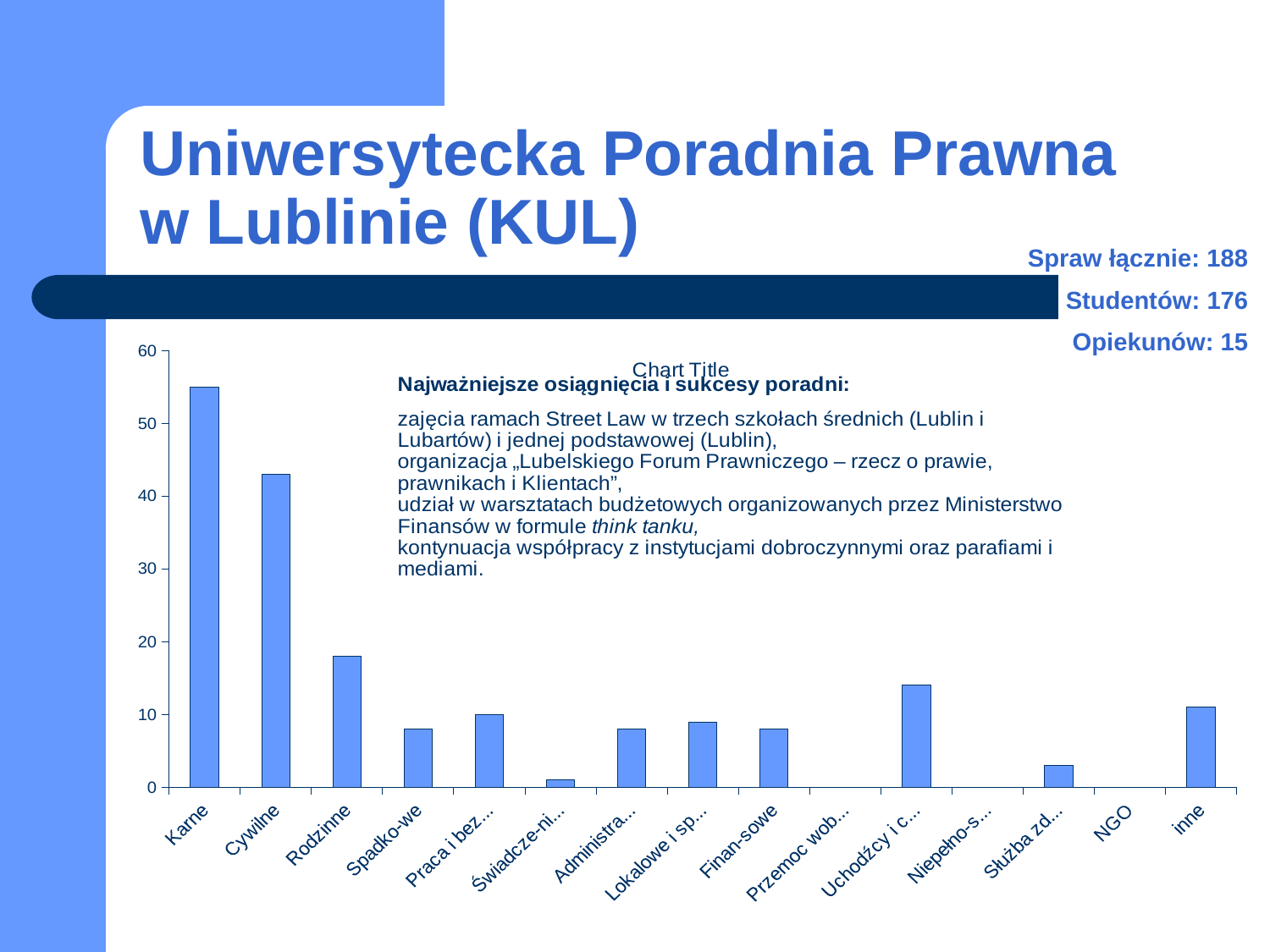
What title is printed on the chart? Chart Title What kind of chart is shown on the slide? bar chart Which is larger, the value for Karne or the value for Cywilne? Karne Which is larger, the value for Rodzinne or the value for Uchodźcy i c...? Rodzinne Is the value for Służba zd... greater or less than 10? less Is the value for Cywilne greater or less than 40? greater Which category has the highest bar in the chart? Karne Is the value for Rodzinne greater or less than 20? less What is the value for NGO in the chart? 0 How many categories are shown on the x axis of the chart? 15